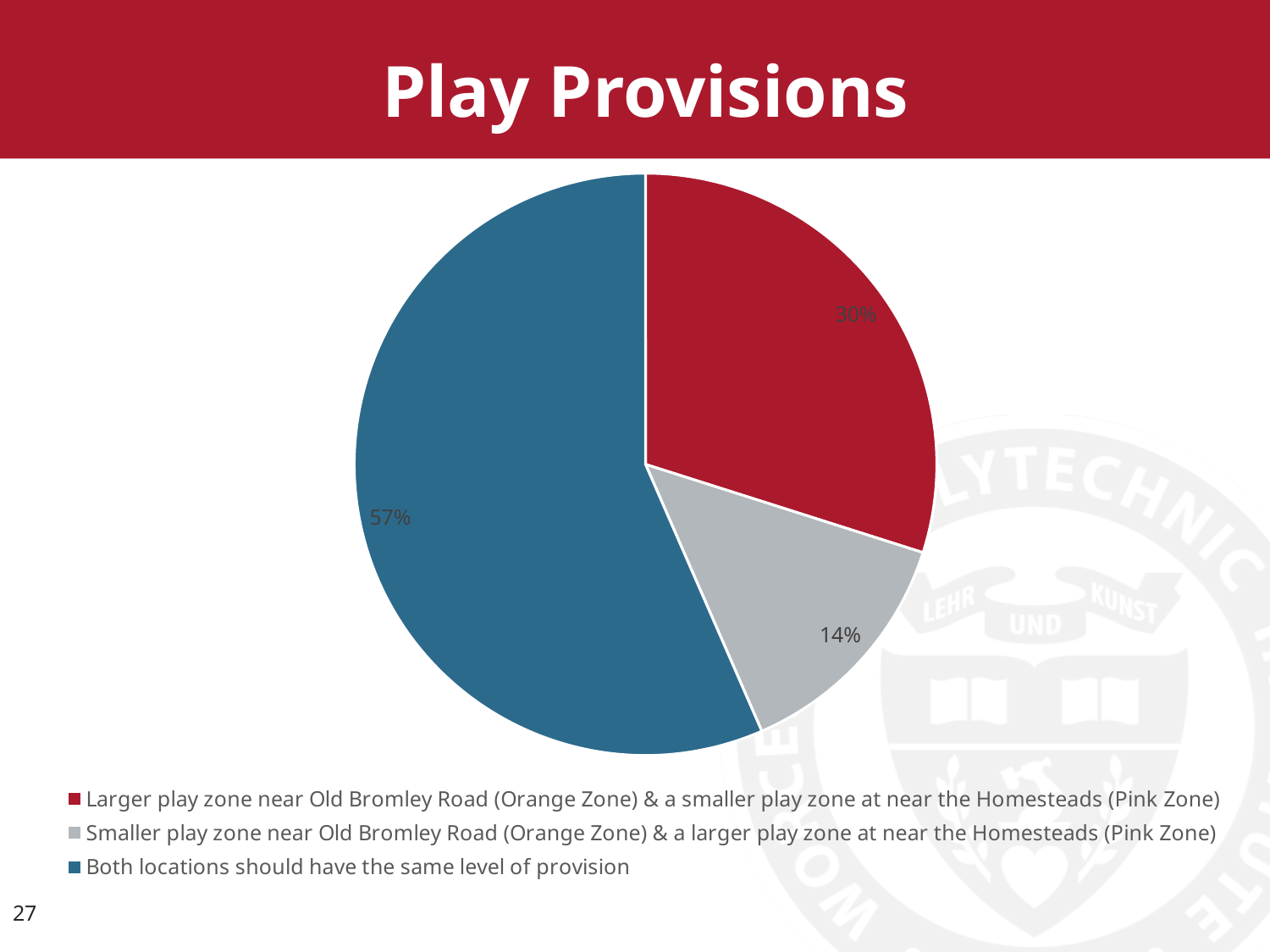
What is the difference in percentage points between the 'Larger play zone near Old Bromley Road' slice and the 'Smaller play zone near Old Bromley Road' slice? 16 percentage points What type of chart is shown on the slide? pie chart What share of the pie is 'Both locations should have the same level of provision'? 57% What is the difference in percentage points between the 'Both locations should have the same level of provision' slice and the 'Larger play zone near Old Bromley Road' slice? 27 percentage points Which option has the largest share of the pie? Both locations should have the same level of provision What share of the pie is 'Larger play zone near Old Bromley Road (Orange Zone) & a smaller play zone at near the Homesteads (Pink Zone)'? 30% How many slices does the pie chart have? 3 What share of the pie is 'Smaller play zone near Old Bromley Road (Orange Zone) & a larger play zone at near the Homesteads (Pink Zone)'? 14% What is the title of the slide containing the pie chart? Play Provisions Which option has the smallest share of the pie? Smaller play zone near Old Bromley Road (Orange Zone) & a larger play zone at near the Homesteads (Pink Zone) What colour is the slice for 'Both locations should have the same level of provision'? blue Which is larger: the 'Larger play zone near Old Bromley Road' slice or the 'Smaller play zone near Old Bromley Road' slice? Larger play zone near Old Bromley Road (Orange Zone) & a smaller play zone at near the Homesteads (Pink Zone)